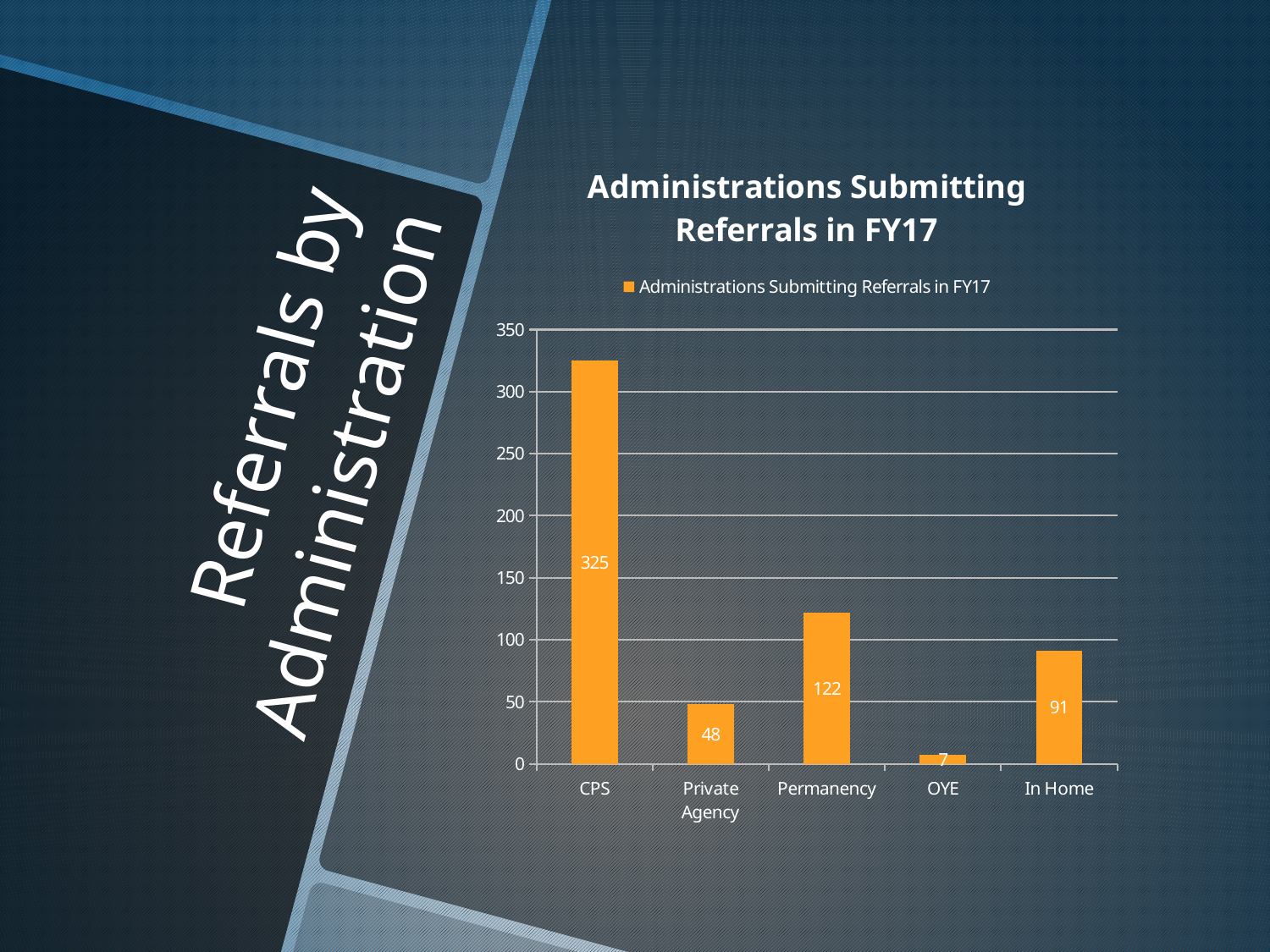
What is the value for In Home? 91 What is the value for Private Agency? 48 Is the value for CPS greater or less than 300? greater What is the difference between the values for CPS and Permanency? 203 Which category has the highest value? CPS What is the value for CPS? 325 What kind of chart is shown? bar chart Which category has the lowest value? OYE How many categories are shown on the x axis? 5 Which is larger, the value for Permanency or the value for In Home? Permanency What is the value for Permanency? 122 What is the title of the chart? Administrations Submitting Referrals in FY17